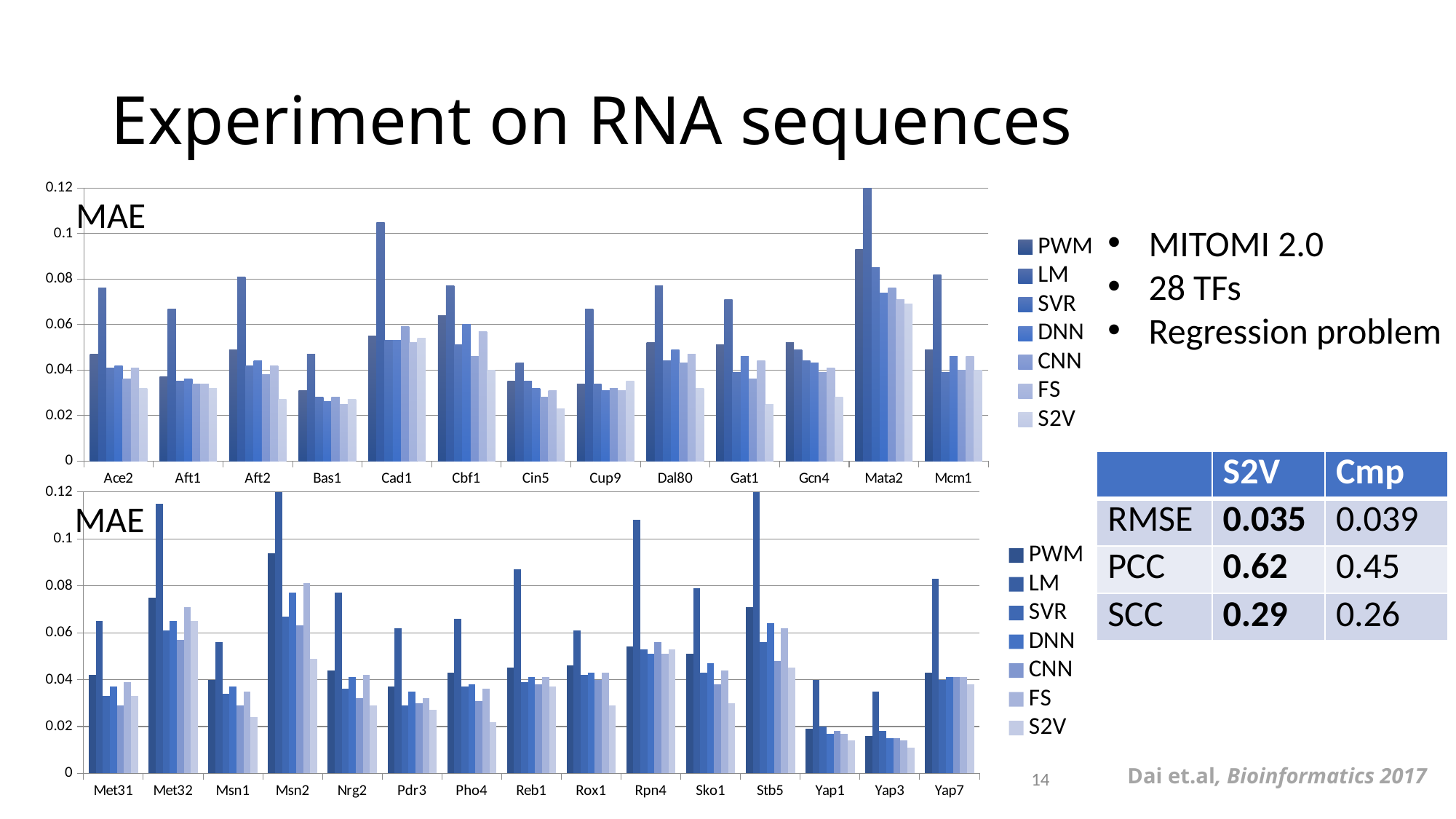
In the bottom chart, is the LM value for Met32 greater or less than 0.1? greater In the top chart, is the LM value for Cad1 greater or less than 0.1? greater In the bottom chart, is the PWM value for Yap3 greater or less than 0.04? less In the top chart, which category contains the tallest bar? Mata2 What kind of chart is the top chart on the slide? bar chart How many categories are shown on the x axis of the bottom chart? 15 How many categories are shown on the x axis of the top chart? 13 How many series does the legend of the top chart list? 7 In the top chart, which is larger: the PWM value for Mata2 or the PWM value for Ace2? Mata2 What metric label is printed inside both charts? MAE